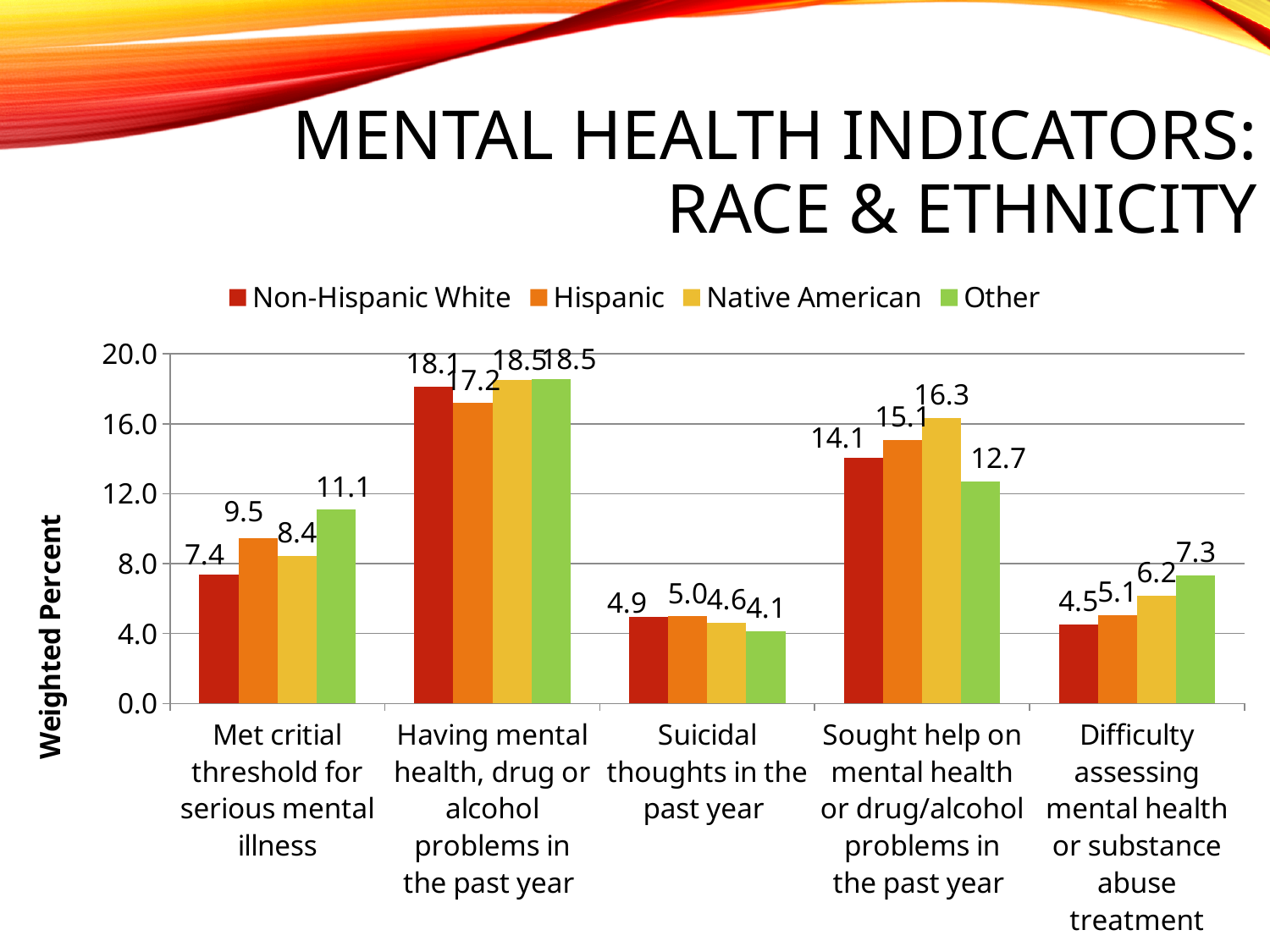
What is the value for Native American in the 'Difficulty assessing mental health or substance abuse treatment' category? 6.2 What is the label of the y axis? Weighted Percent Which group has the lowest value in the 'Suicidal thoughts in the past year' category? Other What is the value for Other in the 'Met critial threshold for serious mental illness' category? 11.1 Which group has the highest value in the 'Sought help on mental health or drug/alcohol problems in the past year' category? Native American What kind of chart is shown on the slide? bar chart What is the value for Non-Hispanic White in the 'Sought help on mental health or drug/alcohol problems in the past year' category? 14.1 What is the difference between the Hispanic and Non-Hispanic White values in the 'Met critial threshold for serious mental illness' category? 2.1 In the 'Having mental health, drug or alcohol problems in the past year' category, which is larger: the Non-Hispanic White value or the Hispanic value? Non-Hispanic White How many categories are shown on the x axis? 5 Is the value for Other in the 'Sought help on mental health or drug/alcohol problems in the past year' category greater or less than 16.0? less How many series does the legend list? 4